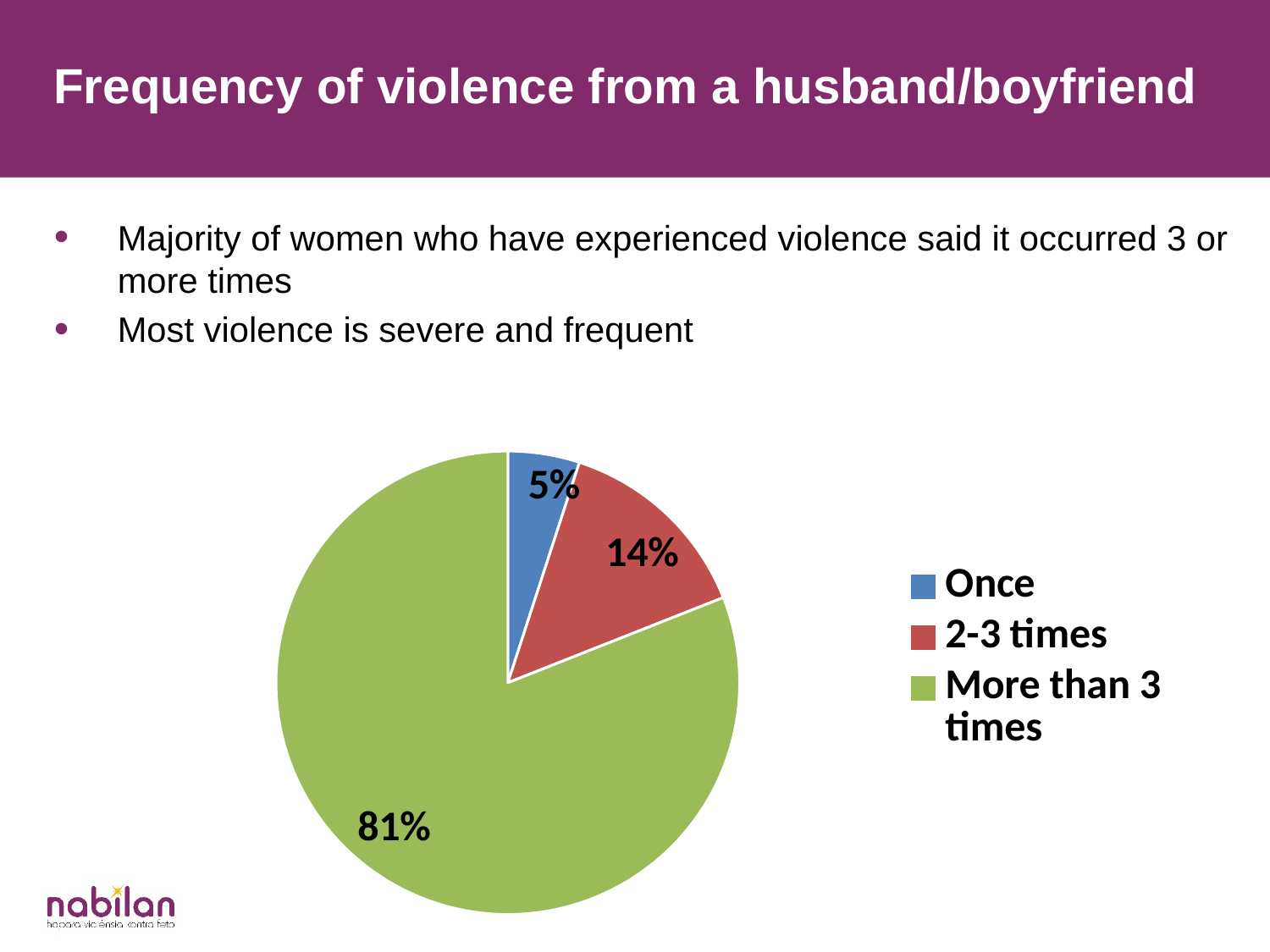
What is the difference in percentage points between the "More than 3 times" slice and the "2-3 times" slice? 67 percentage points What colour is the "More than 3 times" slice? Green How many categories does the pie chart have? 3 What share of the pie is labelled "Once"? 5% What share of the pie is labelled "More than 3 times"? 81% What share of the pie is labelled "2-3 times"? 14% What is the title of the slide containing the pie chart? Frequency of violence from a husband/boyfriend Which is larger, the "Once" slice or the "2-3 times" slice? 2-3 times Which category has the smallest slice of the pie? Once Which category has the largest slice of the pie? More than 3 times What is the difference in percentage points between the "2-3 times" slice and the "Once" slice? 9 percentage points What kind of chart is shown on the slide? Pie chart